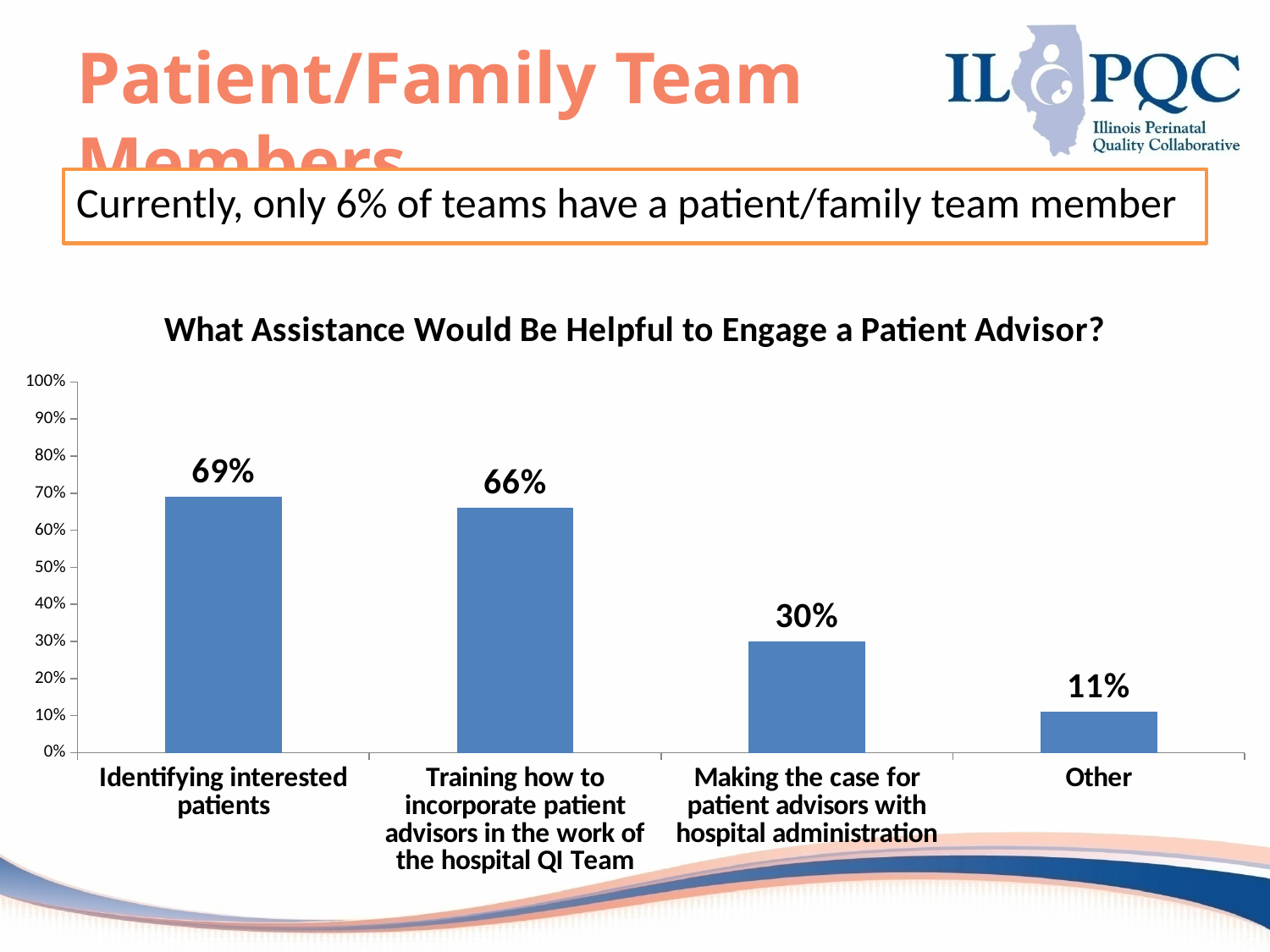
What kind of chart is shown on the slide? Bar chart Which category has the highest value? Identifying interested patients What is the difference between the values for "Identifying interested patients" and "Making the case for patient advisors with hospital administration"? 39% Which is larger: the value for "Training how to incorporate patient advisors in the work of the hospital QI Team" or the value for "Making the case for patient advisors with hospital administration"? Training how to incorporate patient advisors in the work of the hospital QI Team What is the title of the chart? What Assistance Would Be Helpful to Engage a Patient Advisor? What is the value for "Training how to incorporate patient advisors in the work of the hospital QI Team"? 66% What is the value for "Identifying interested patients"? 69% What is the value for "Other"? 11% How many categories are shown in the chart? 4 What is the value for "Making the case for patient advisors with hospital administration"? 30% Which category has the lowest value? Other What is the difference between the values for "Making the case for patient advisors with hospital administration" and "Other"? 19%